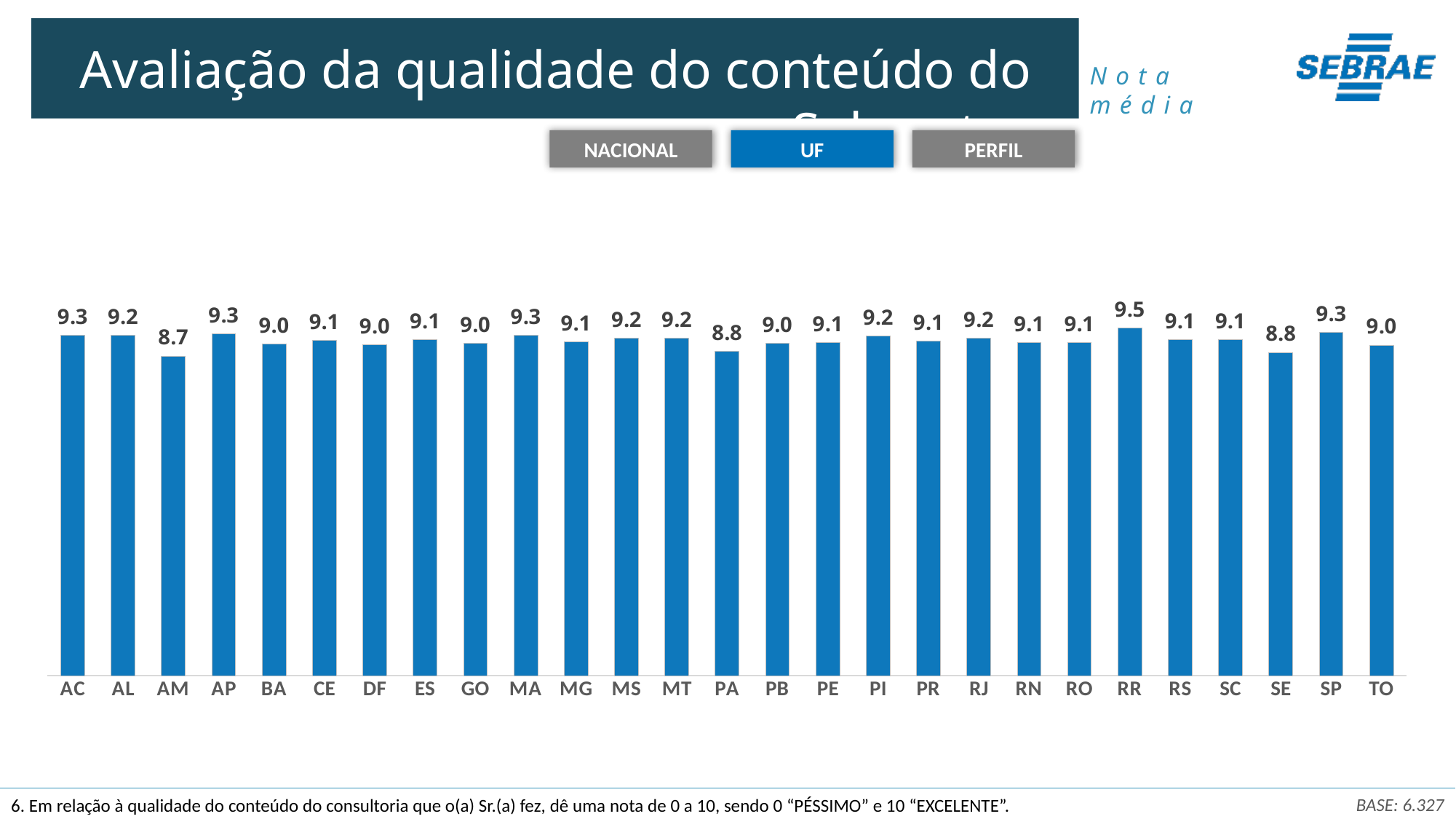
Which UF has the highest value? RR Which UF has the lowest value? AM How many UF categories are plotted in the chart? 27 What is the value for AM? 8.7 What kind of chart is shown on the slide? bar chart What is the value for SP? 9.3 What is the difference between the values for MA and PA? 0.5 What colour are the bars in the chart? blue What is the value for RR? 9.5 What is the value for PA? 8.8 What is the difference between the values for RR and AM? 0.8 Which is larger, the value for AC or the value for SE? AC